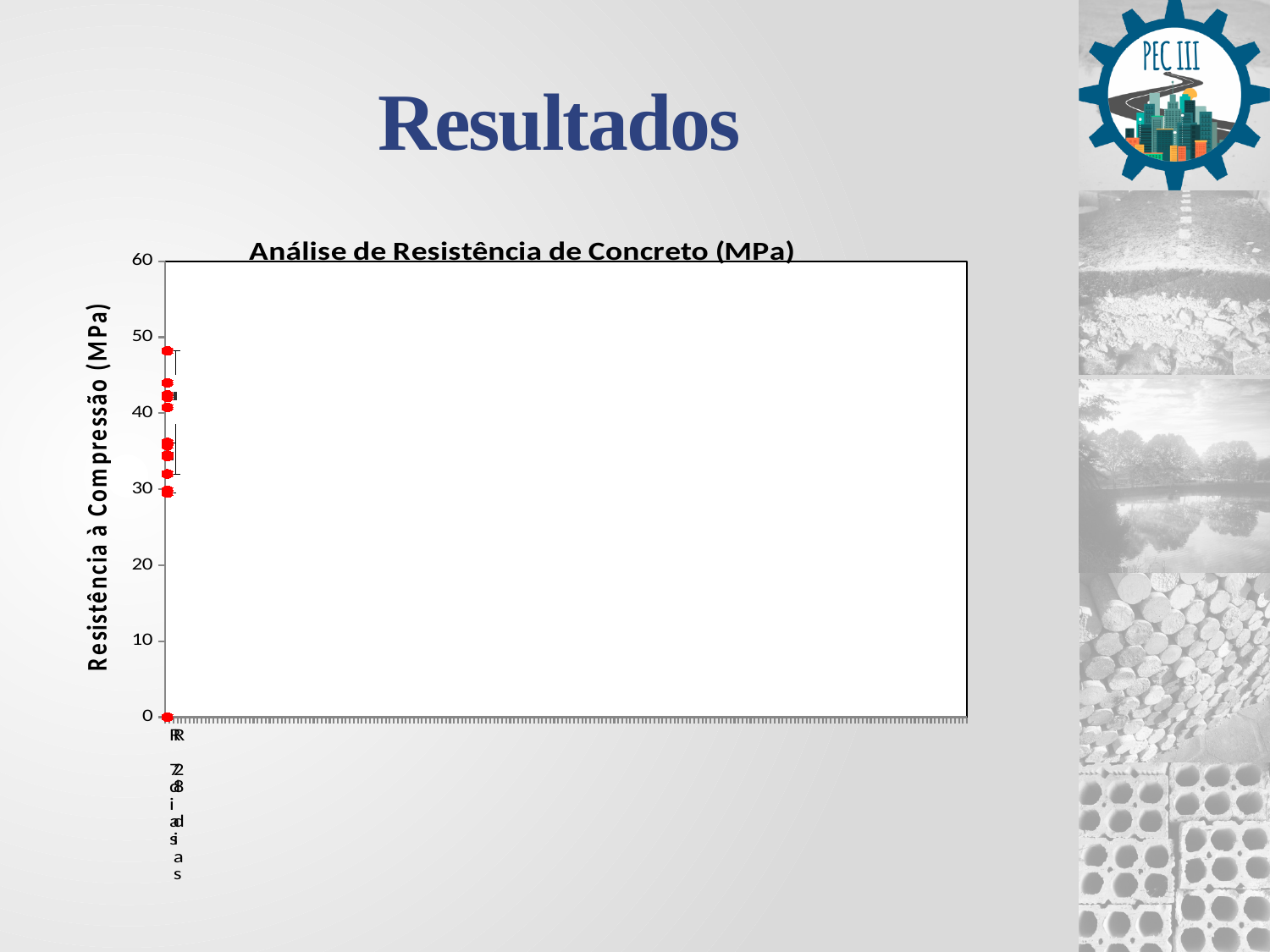
Is the highest plotted value in the chart greater or less than 50? less What is the title of the chart? Análise de Resistência de Concreto (MPa) What is the maximum value shown on the vertical axis of the chart? 60 What is the label of the vertical axis of the chart? Resistência à Compressão (MPa) What type of chart is shown on the slide? scatter chart Is the highest plotted value in the chart greater or less than 40? greater